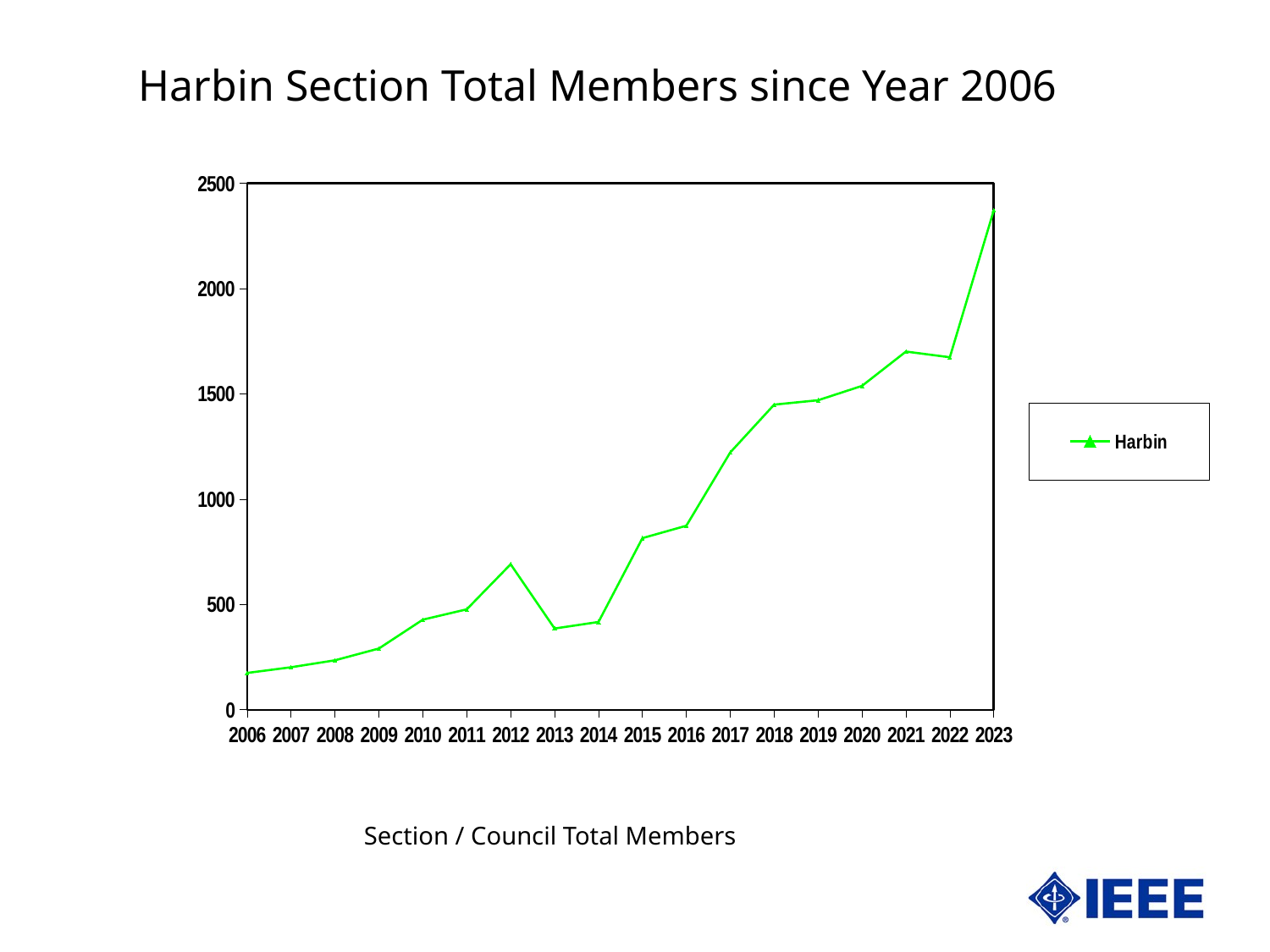
How many series does the legend list? 1 Which year has the highest number of Harbin Section members? 2023 What kind of chart is shown on the slide? line chart How many years are plotted along the x axis? 18 Is the value for 2013 greater or less than 500? less Is the value for 2017 greater or less than 1000? greater Which year has the larger value, 2012 or 2014? 2012 Overall, do the values rise or fall from 2006 to 2023? rise Which year has the lowest number of Harbin Section members? 2006 What is the name of the series shown in the legend? Harbin Is the value for 2012 greater or less than 500? greater